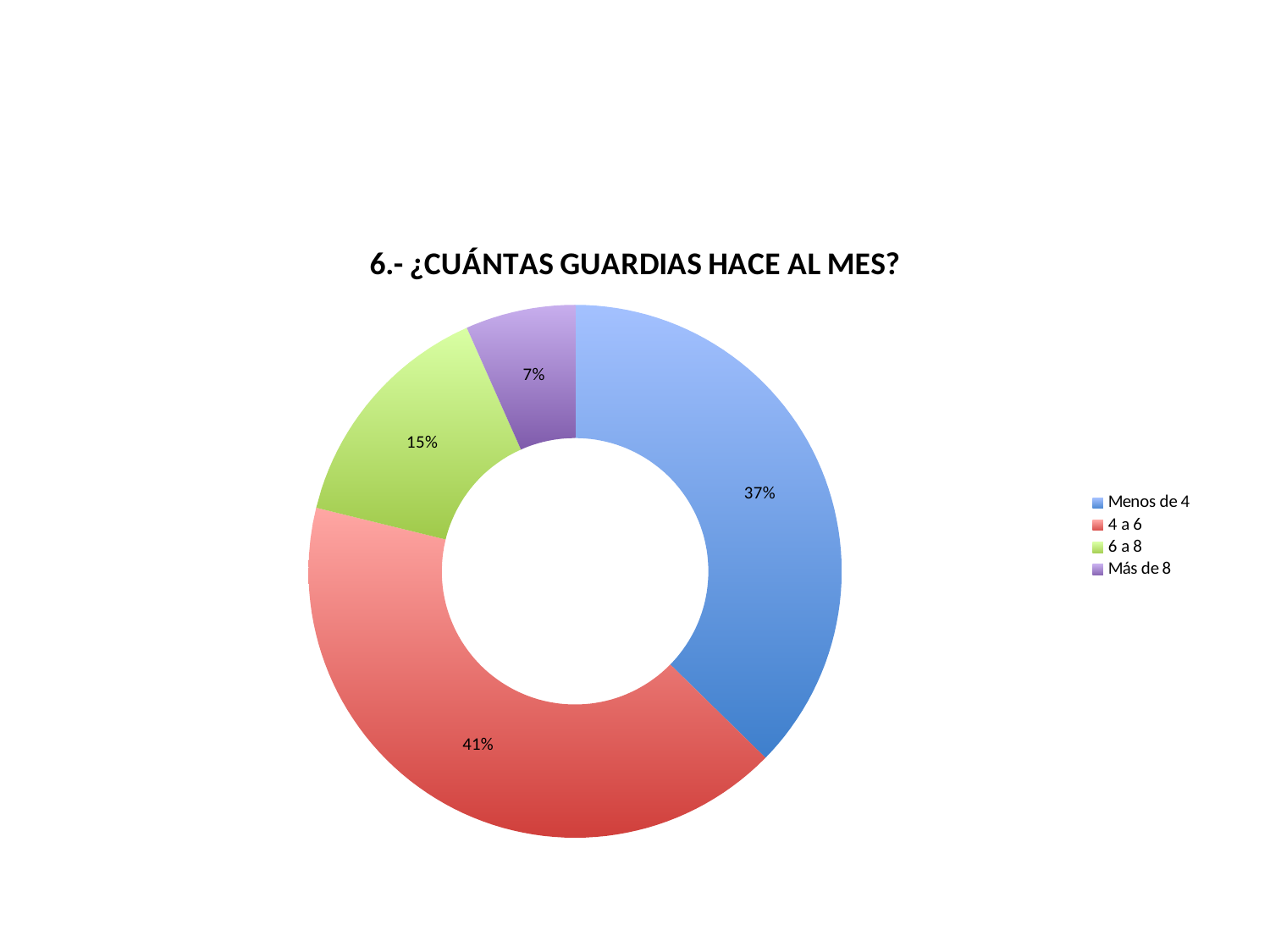
What share of the chart does the "4 a 6" slice represent? 41% What is the title of the chart? 6.- ¿CUÁNTAS GUARDIAS HACE AL MES? What is the value shown for "Más de 8"? 7% Which is larger, the share for "6 a 8" or the share for "Más de 8"? 6 a 8 Which category has the largest share? 4 a 6 What is the difference in percentage points between "6 a 8" and "Más de 8"? 8 What is the value shown for "6 a 8"? 15% What kind of chart is shown on the slide? Doughnut (pie) chart What is the value shown for "Menos de 4"? 37% How many categories does the chart show? 4 Which category has the smallest share? Más de 8 What is the difference in percentage points between "4 a 6" and "Menos de 4"? 4